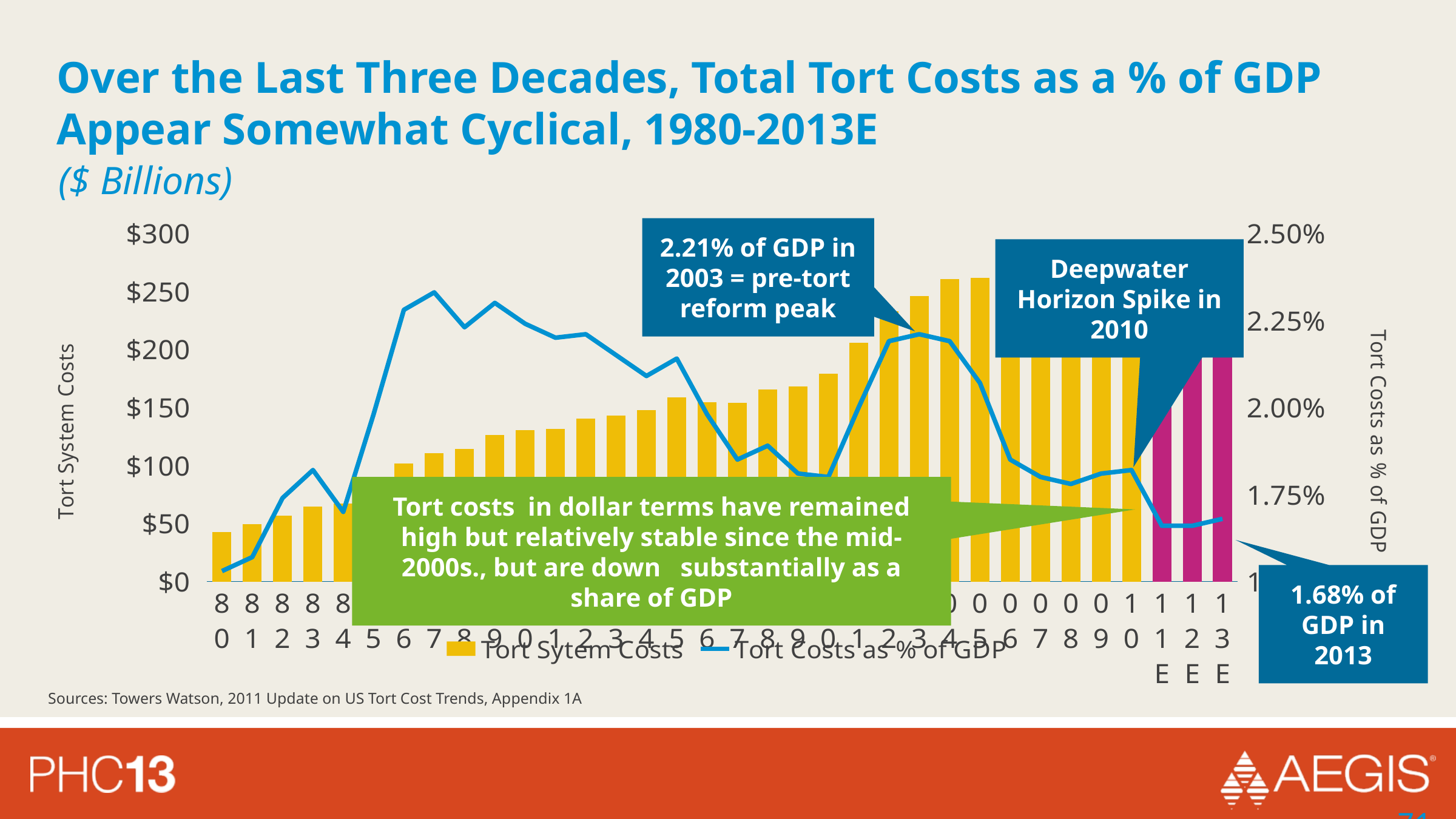
What is the label on the right-hand vertical axis? Tort Costs as % of GDP In which year does the Tort Costs as % of GDP line reach its highest point? 1987 Is the Tort System Costs bar for 1980 greater or less than $50? less Do the Tort System Costs bars generally rise or fall from 1980 to 2005? rise According to the callout, what are tort costs as a % of GDP in 2013? 1.68% Is the Tort System Costs bar for 2005 greater or less than $250? greater According to the callout, what were tort costs as a % of GDP in 2003? 2.21% Which year has the larger Tort System Costs bar, 1980 or 2005? 2005 How many series does the chart's legend list? 2 Which year has the lowest Tort System Costs bar? 1980 Is the Tort Costs as % of GDP value for 1987 greater or less than 2.25%? greater What kind of chart is shown on the slide? Combined bar and line chart